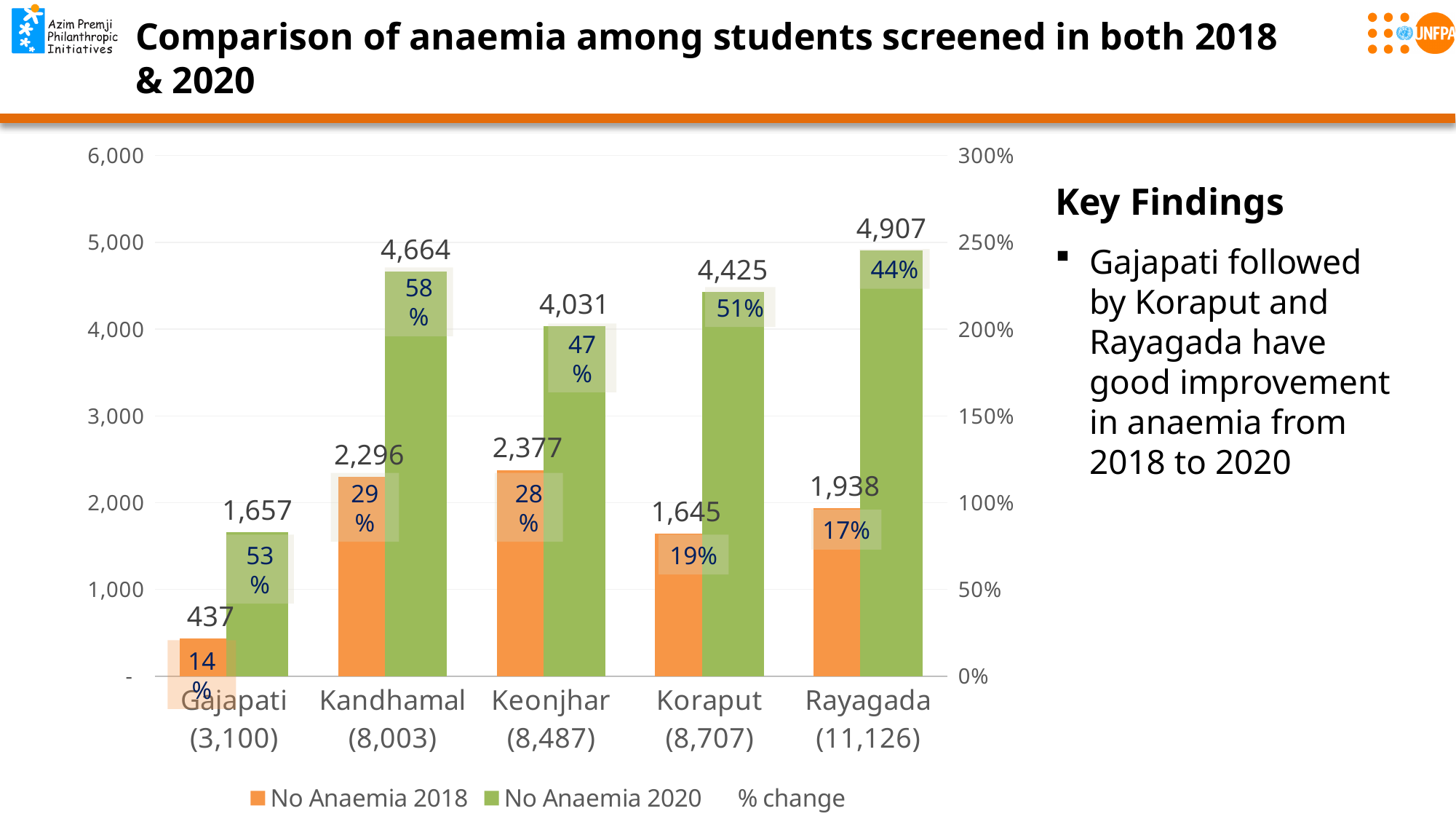
Which is larger, the No Anaemia 2020 value for Kandhamal (8,003) or for Koraput (8,707)? Kandhamal (8,003) How many districts are shown on the x axis? 5 How many series does the legend list? 3 Which district has the lowest No Anaemia 2018 value? Gajapati (3,100) What kind of chart is shown on the slide? bar chart Which colour represents the No Anaemia 2020 series? green What is the No Anaemia 2018 value for Keonjhar (8,487)? 2,377 What is the difference between the No Anaemia 2020 and No Anaemia 2018 values for Koraput (8,707)? 2,780 What is the No Anaemia 2018 value for Gajapati (3,100)? 437 Is the No Anaemia 2020 value for Gajapati (3,100) greater or less than 2,000? less What is the No Anaemia 2020 value for Rayagada (11,126)? 4,907 Which district has the highest No Anaemia 2020 value? Rayagada (11,126)